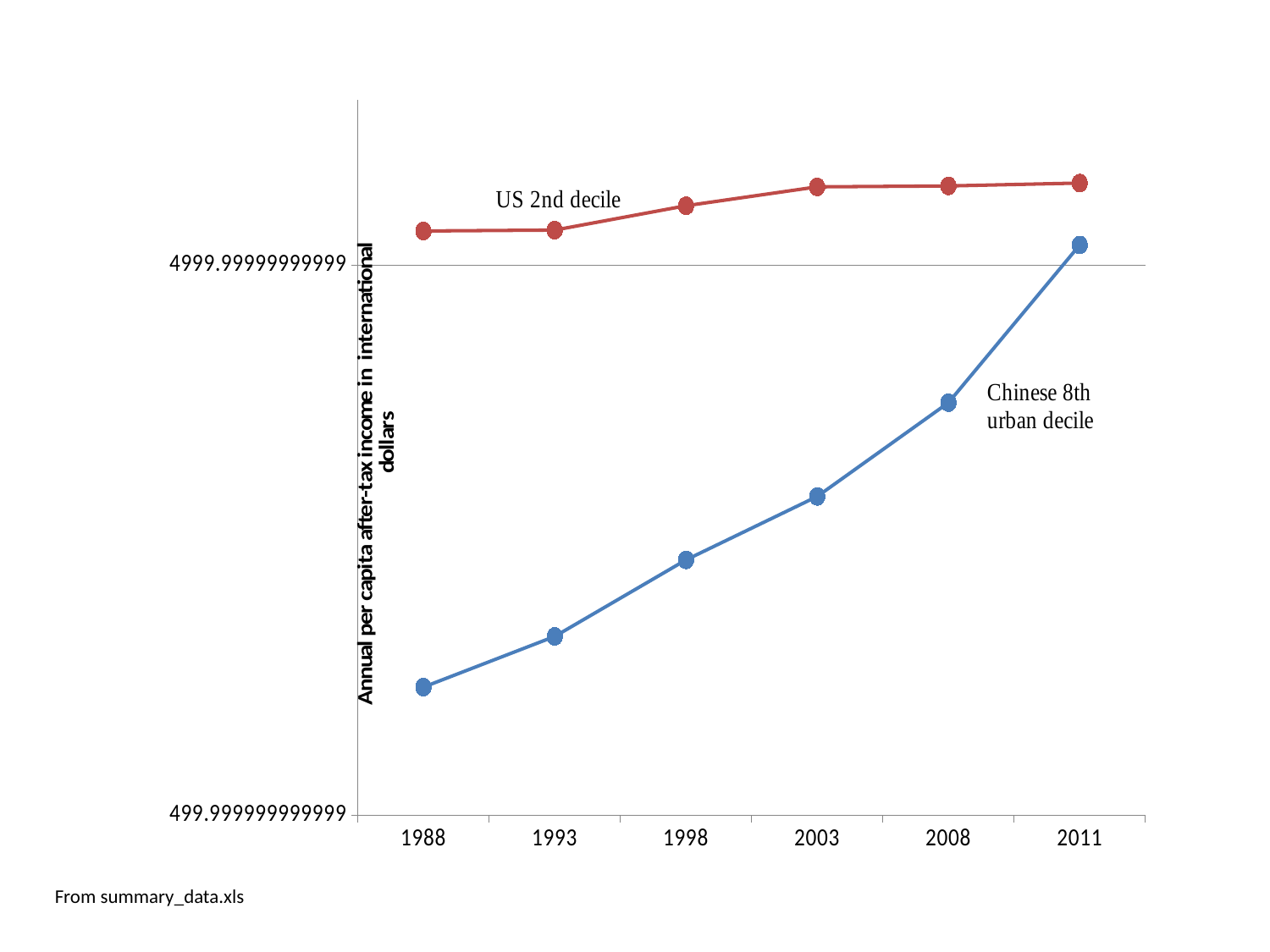
Is the value for the US 2nd decile in 1988 greater or less than 4999.99999999999? greater Is the value for the Chinese 8th urban decile in 2011 greater or less than 4999.99999999999? greater What is the label of the y axis? Annual per capita after-tax income in international dollars In which year is the Chinese 8th urban decile value highest? 2011 How many years are shown on the x axis? 6 In which year is the Chinese 8th urban decile value lowest? 1988 Which series has the higher value in 1998, US 2nd decile or Chinese 8th urban decile? US 2nd decile What kind of chart is shown on the slide? line chart Which series is labelled with the red line? US 2nd decile How many series are plotted on the chart? 2 Does the Chinese 8th urban decile series rise or fall from 1988 to 2011? rise Is the value for the Chinese 8th urban decile in 2008 greater or less than 4999.99999999999? less